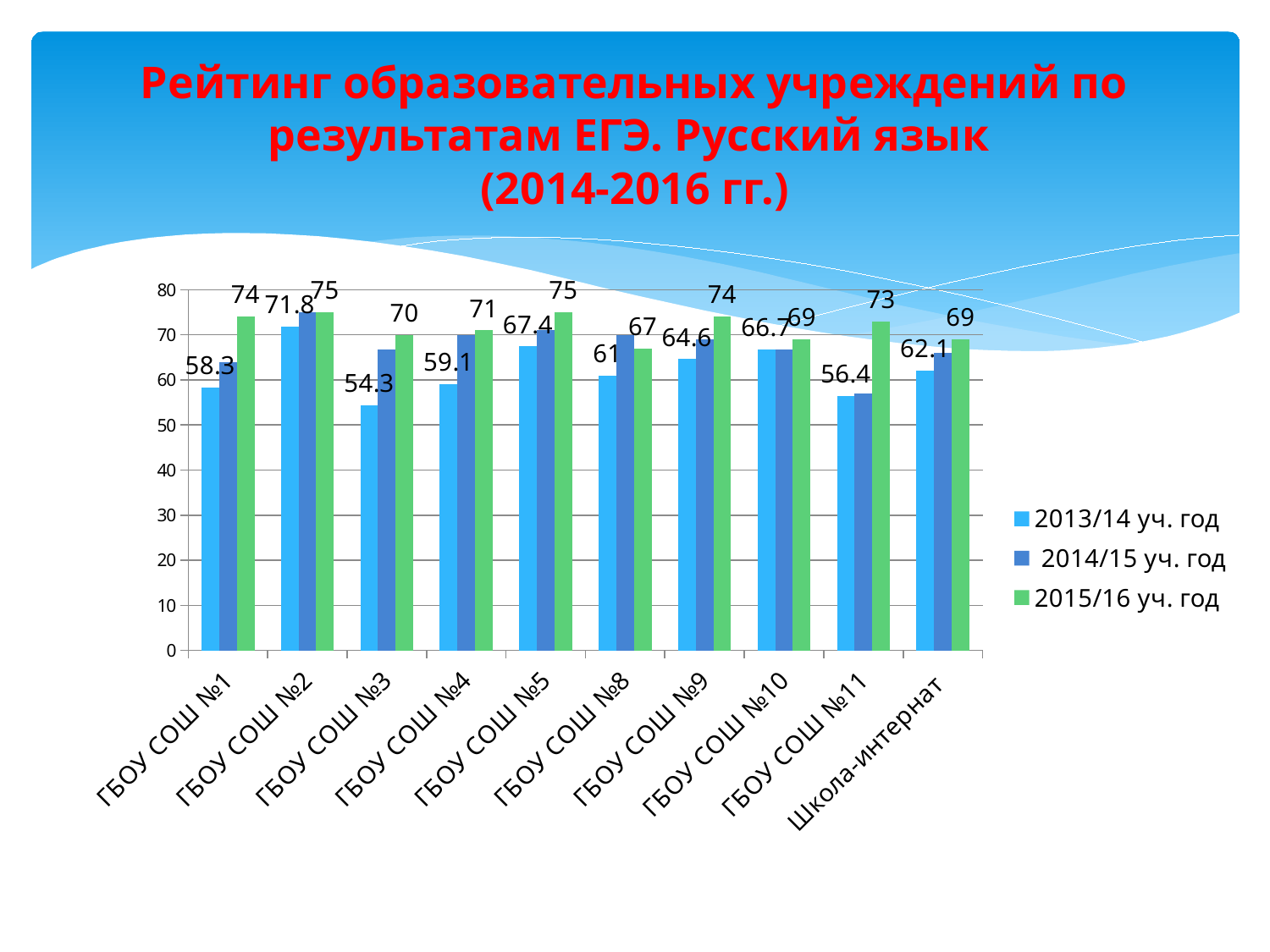
What is the difference between the 2015/16 уч. год and 2013/14 уч. год values for ГБОУ СОШ №11? 16.6 What is the 2013/14 уч. год value for ГБОУ СОШ №1? 58.3 Which institution has the lowest 2015/16 уч. год value? ГБОУ СОШ №8 How many institutions are shown on the x axis? 10 How many series does the legend list? 3 Which institution has the lowest 2013/14 уч. год value? ГБОУ СОШ №3 Is the 2014/15 уч. год value for ГБОУ СОШ №11 greater or less than 60? less What kind of chart is shown on the slide? bar chart What is the 2015/16 уч. год value for ГБОУ СОШ №11? 73 Which institution has the highest 2013/14 уч. год value? ГБОУ СОШ №2 What is the 2013/14 уч. год value for Школа-интернат? 62.1 Which is larger for ГБОУ СОШ №9: the 2013/14 уч. год value or the 2015/16 уч. год value? 2015/16 уч. год